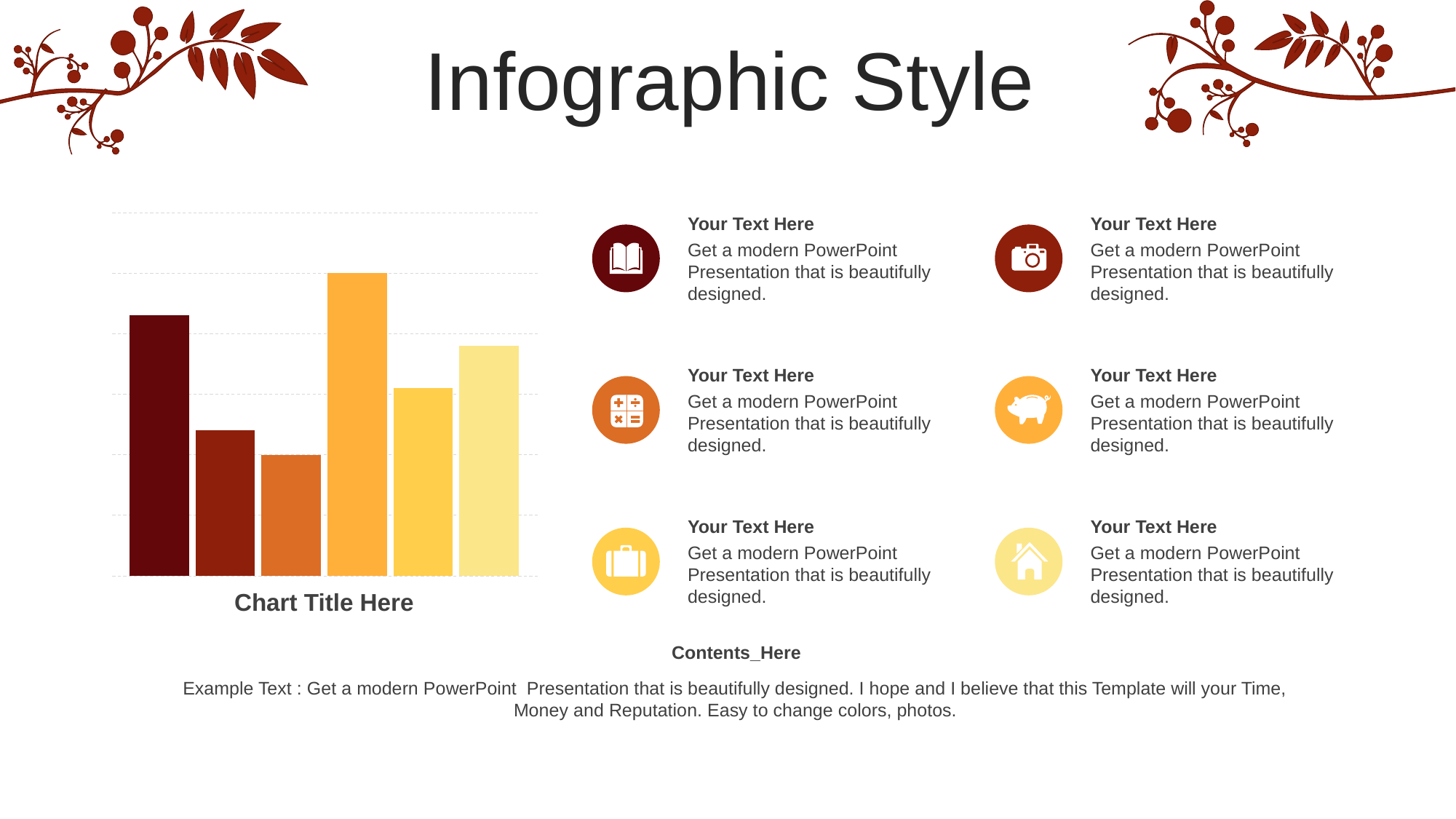
Which is taller in the chart: the first bar or the fourth bar from the left? the fourth bar How many bars does the chart on the left contain? 6 Which is taller in the chart: the first bar or the second bar from the left? the first bar What is the title shown beneath the chart? Chart Title Here What colour is the tallest bar in the chart? light orange Which bar in the chart is the tallest, counting from the left? the fourth bar Which is taller in the chart: the second bar or the third bar from the left? the second bar What kind of chart is shown on the left of the slide? bar chart Which bar in the chart is the shortest, counting from the left? the third bar